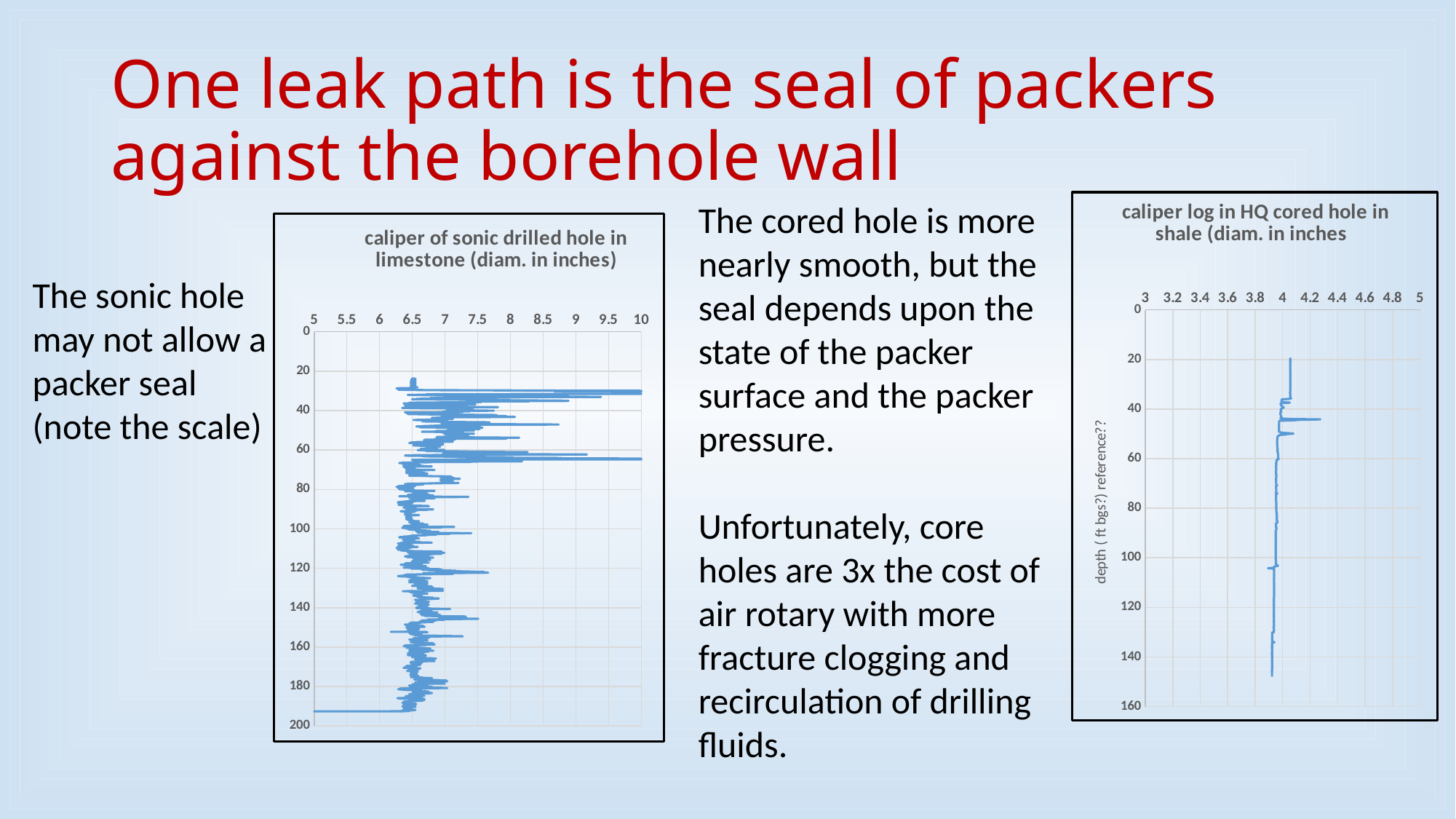
In the right chart (HQ cored hole in shale), is the diameter at a depth of 60 greater or less than 4.4? less In the left chart (sonic drilled hole in limestone), is the smallest diameter plotted greater or less than 5.5? less Which chart shows a wider range of hole diameters, the left chart (sonic drilled hole in limestone) or the right chart (HQ cored hole in shale)? the left chart (sonic drilled hole in limestone) What kind of chart is the right chart titled 'caliper log in HQ cored hole in shale (diam. in inches'? line chart In the right chart (HQ cored hole in shale), is the diameter at a depth of 140 greater or less than 4.4? less What is the title of the chart on the left of the slide? caliper of sonic drilled hole in limestone (diam. in inches) What kind of chart is the left chart titled 'caliper of sonic drilled hole in limestone (diam. in inches)'? line chart In the right chart, what is the label on the vertical axis? depth ( ft bgs?) reference??